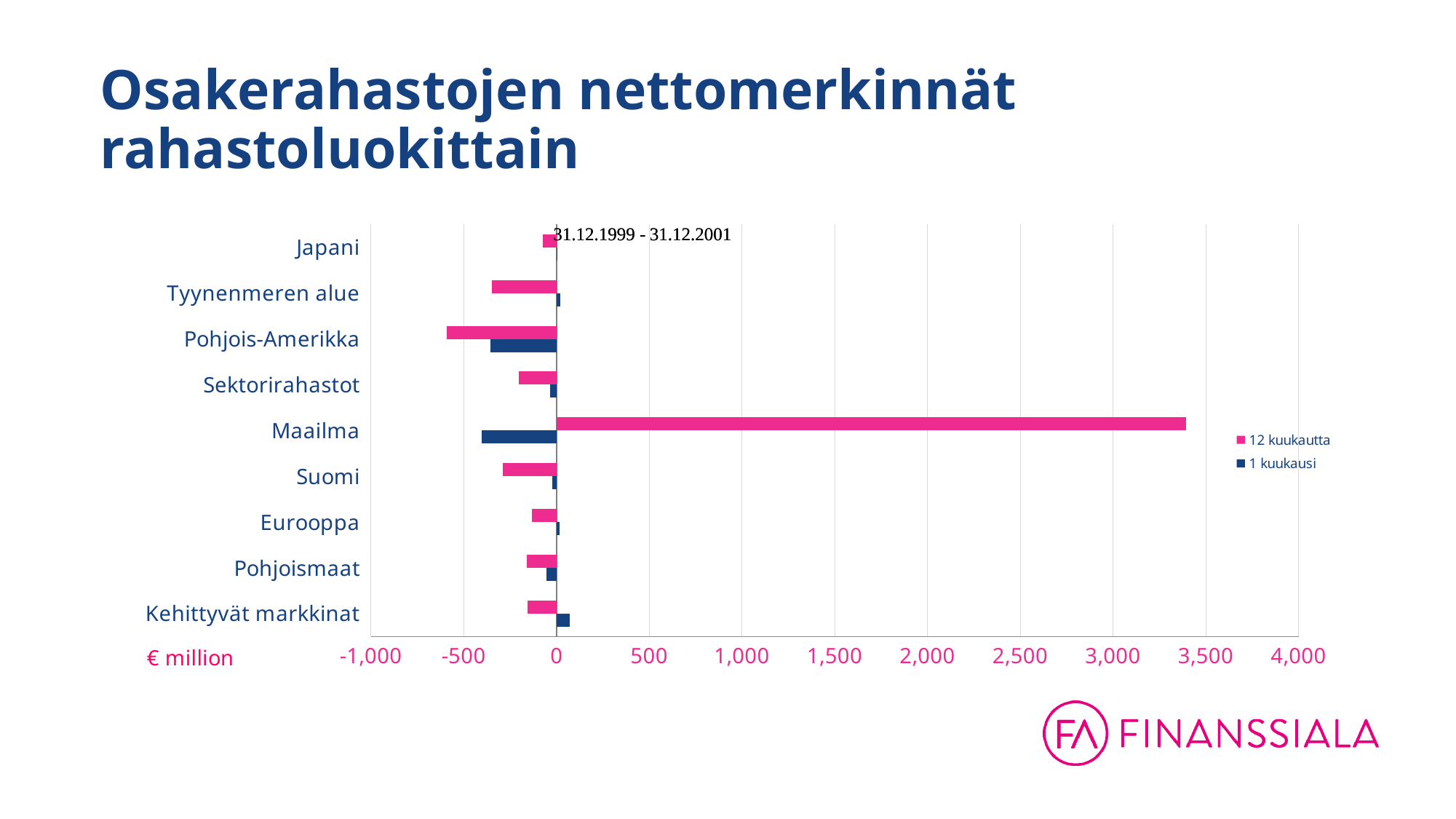
Is the 1 kuukausi value for Maailma greater or less than 0? less Which category has the highest value for the 1 kuukausi series? Kehittyvät markkinat How many fund categories are plotted on the chart? 9 How many series does the chart's legend list? 2 Is the 12 kuukautta value for Maailma greater or less than 3,000? greater What are the two series named in the legend? 12 kuukautta and 1 kuukausi Which category has the highest value for the 12 kuukautta series? Maailma What kind of chart is shown on the slide? bar chart Which is larger, the 12 kuukautta value for Tyynenmeren alue or for Pohjois-Amerikka? Tyynenmeren alue What unit is shown for the horizontal axis? € million Is the 12 kuukautta value for Pohjois-Amerikka greater or less than -500? less Which category has the lowest value for the 12 kuukautta series? Pohjois-Amerikka